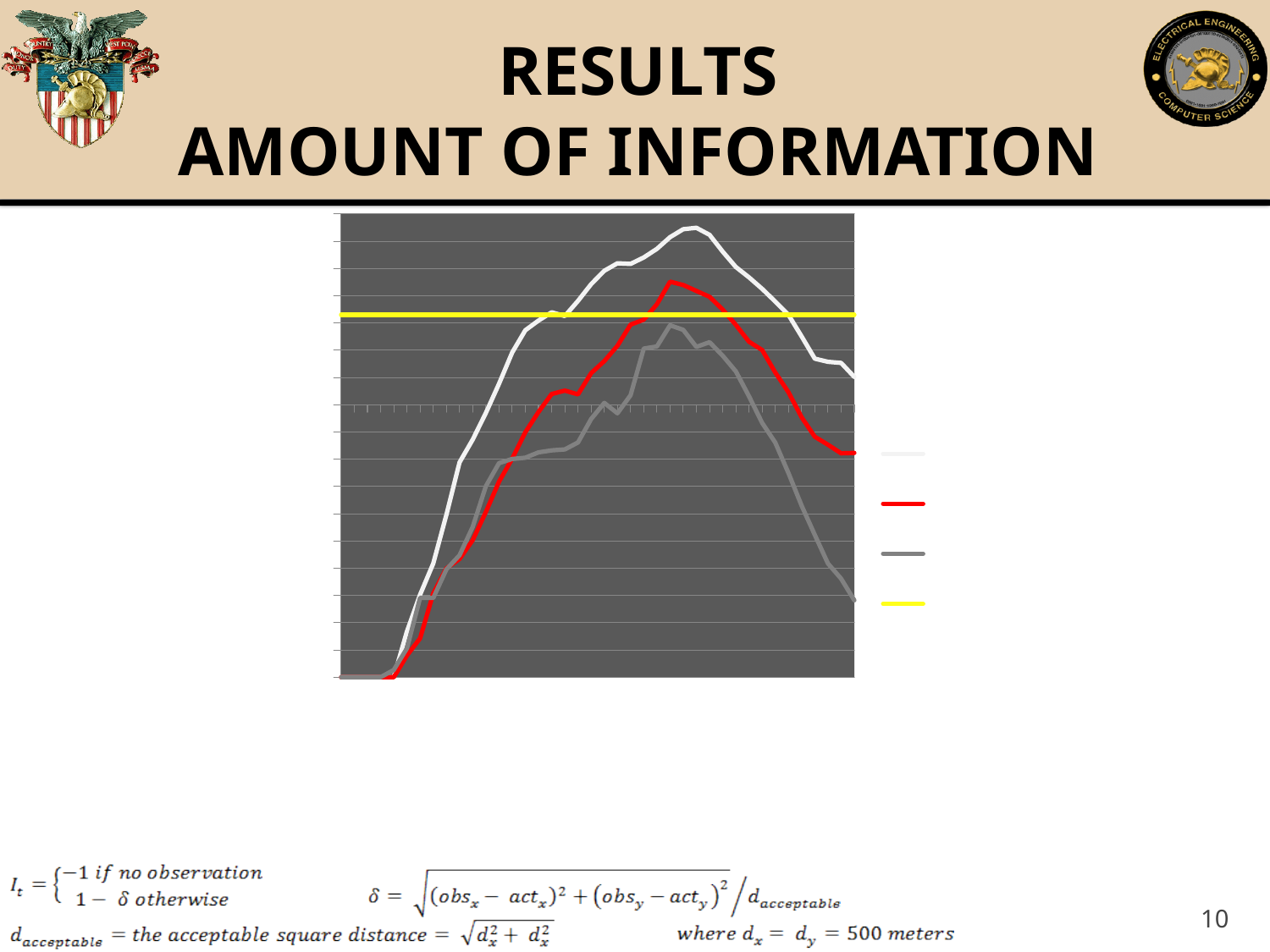
At the right-hand end of the chart, which is higher, the white line or the red line? the white line How many series does the legend list? 4 What kind of chart is shown on the slide? line chart Which line on the chart is flat (horizontal) across the whole x axis? the yellow line Does the gray line rise or fall over the right-hand portion of the chart after its peak? fall What colour is the chart's plot area background? dark gray Which line is higher at its peak, the red line or the gray line? the red line Which line is lowest at the right-hand end of the chart? the gray line Does the white line rise or fall over the left half of the chart? rise Which line reaches the highest peak on the chart? the white line